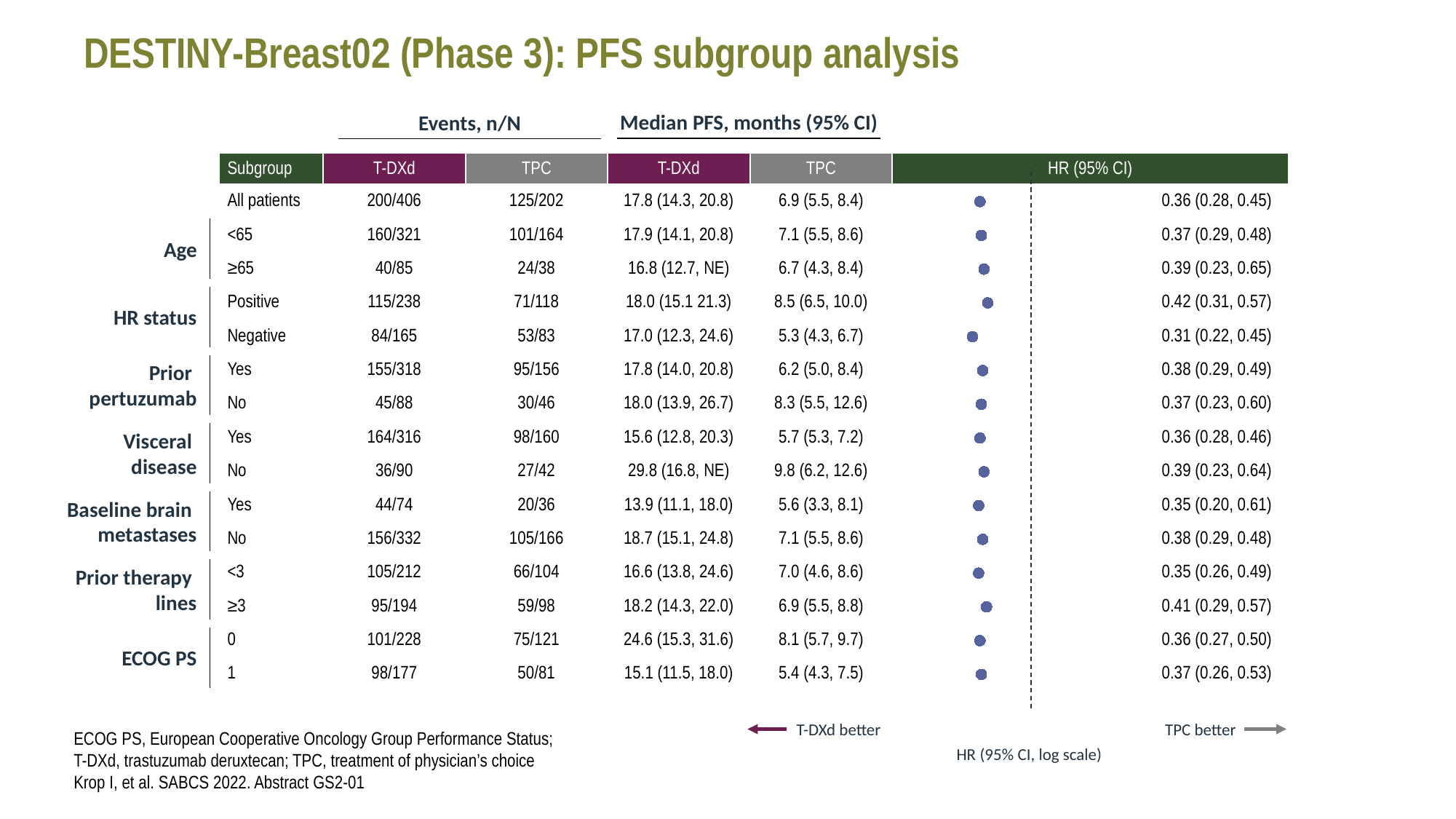
What is the HR (95% CI) for the HR status Negative subgroup? 0.31 (0.22, 0.45) What kind of chart is shown on the right side of the slide? Forest plot Which subgroup has the highest hazard ratio point estimate in the forest plot? HR status Positive (0.42) How many subgroup rows are plotted in the forest plot, including All patients? 15 Which subgroup has the lowest hazard ratio point estimate in the forest plot? HR status Negative (0.31) What is the HR (95% CI) for the All patients row in the forest plot? 0.36 (0.28, 0.45) Is the hazard ratio for the Baseline brain metastases Yes subgroup greater or less than 1? less What scale is used for the HR axis of the forest plot, as stated below the chart? Log scale According to the arrows below the forest plot, which treatment is favoured when the hazard ratio point lies to the left of the dashed line? T-DXd What is the difference between the highest hazard ratio (HR status Positive) and the lowest hazard ratio (HR status Negative)? 0.11 What is the median PFS for T-DXd in the Visceral disease No subgroup? 29.8 (16.8, NE) Which has the larger hazard ratio: Prior therapy lines <3 or Prior therapy lines ≥3? Prior therapy lines ≥3 (0.41)